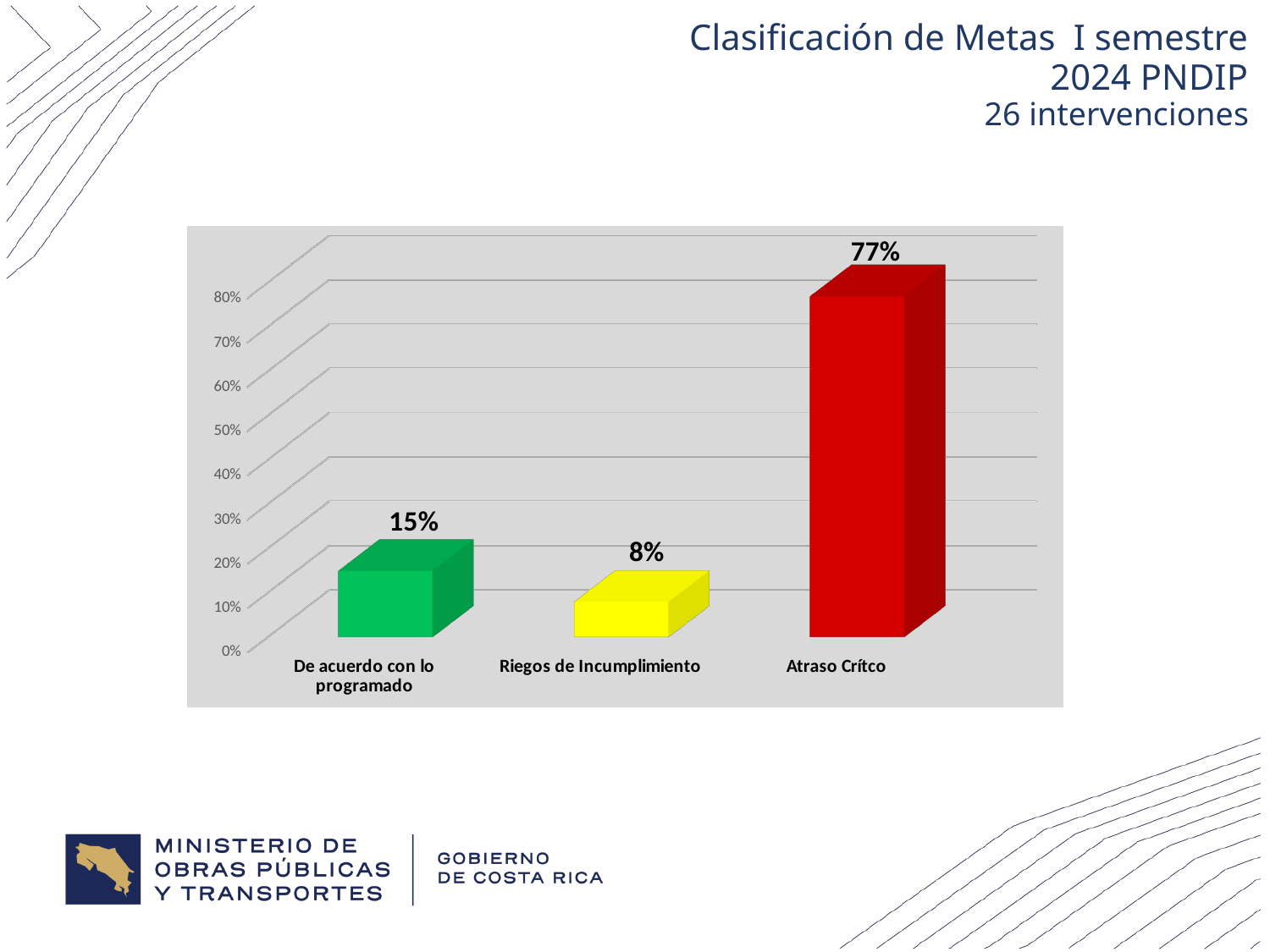
How many categories are shown on the chart? 3 What is the difference between the values for "Atraso Crítco" and "De acuerdo con lo programado"? 62% What is the value for "Atraso Crítco"? 77% Which category has the highest value? Atraso Crítco What kind of chart is shown on the slide? bar chart What is the value for "Riegos de Incumplimiento"? 8% What colour is the bar for "Atraso Crítco"? red Which category has the lowest value? Riegos de Incumplimiento What is the value for "De acuerdo con lo programado"? 15% Is the value for "Atraso Crítco" greater or less than 70%? greater What is the difference between the values for "De acuerdo con lo programado" and "Riegos de Incumplimiento"? 7% Which is larger, the value for "De acuerdo con lo programado" or the value for "Riegos de Incumplimiento"? De acuerdo con lo programado